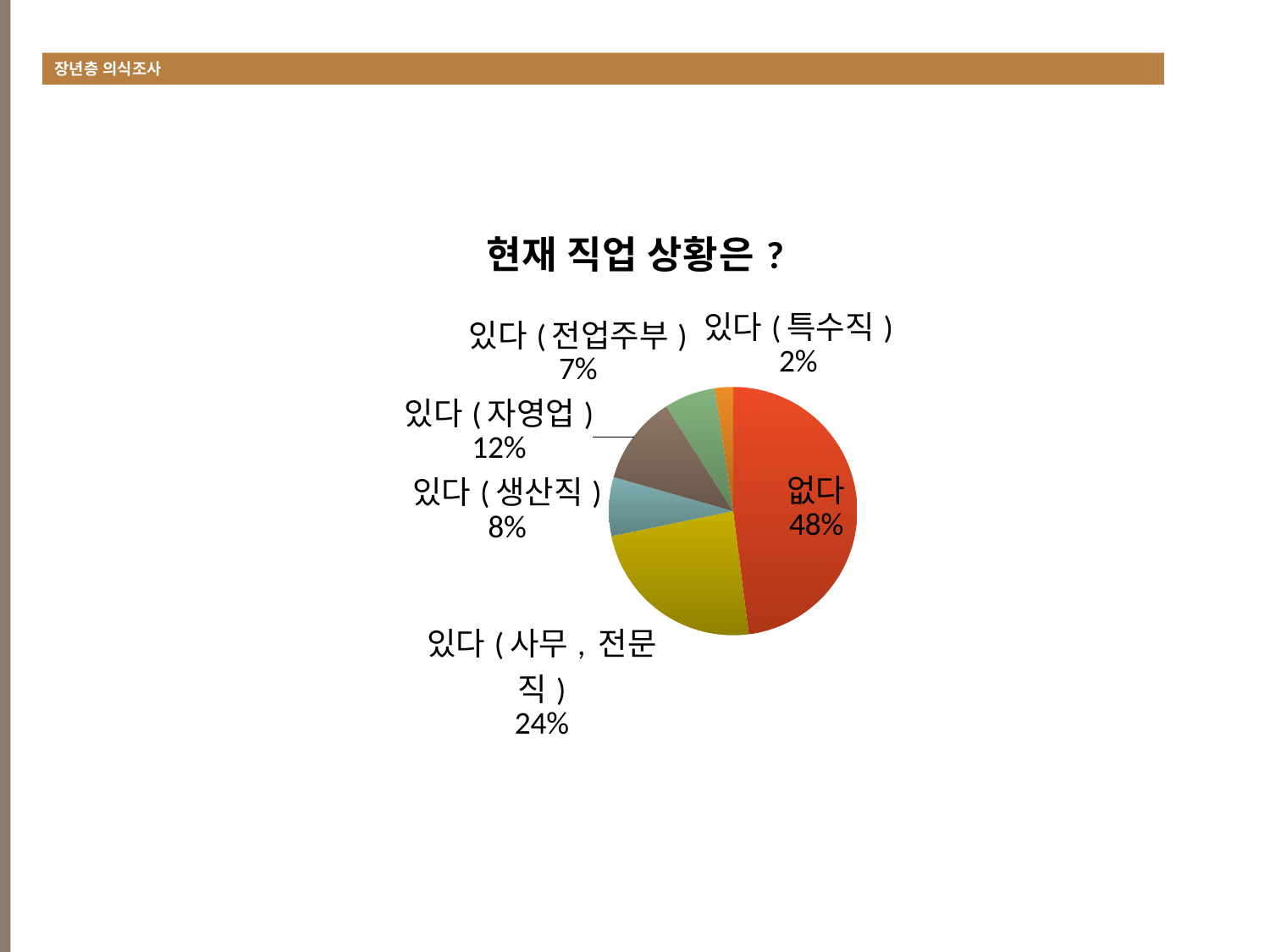
What is the value for 있다 ( 사무 , 전문직 )? 24% What is the value for 있다 ( 전업주부 )? 7% Which category has the smallest share of the pie? 있다 ( 특수직 ) What is the value for 있다 ( 생산직 )? 8% What is the value for 있다 ( 특수직 )? 2% What is the value for 있다 ( 자영업 )? 12% What is the title of the chart? 현재 직업 상황은 ? What share of the pie does 없다 represent? 48% How many categories are shown in the pie chart? 6 Which category has the largest share of the pie? 없다 What kind of chart is shown on the slide? pie chart What is the difference between the shares of 없다 and 있다 ( 사무 , 전문직 )? 24%